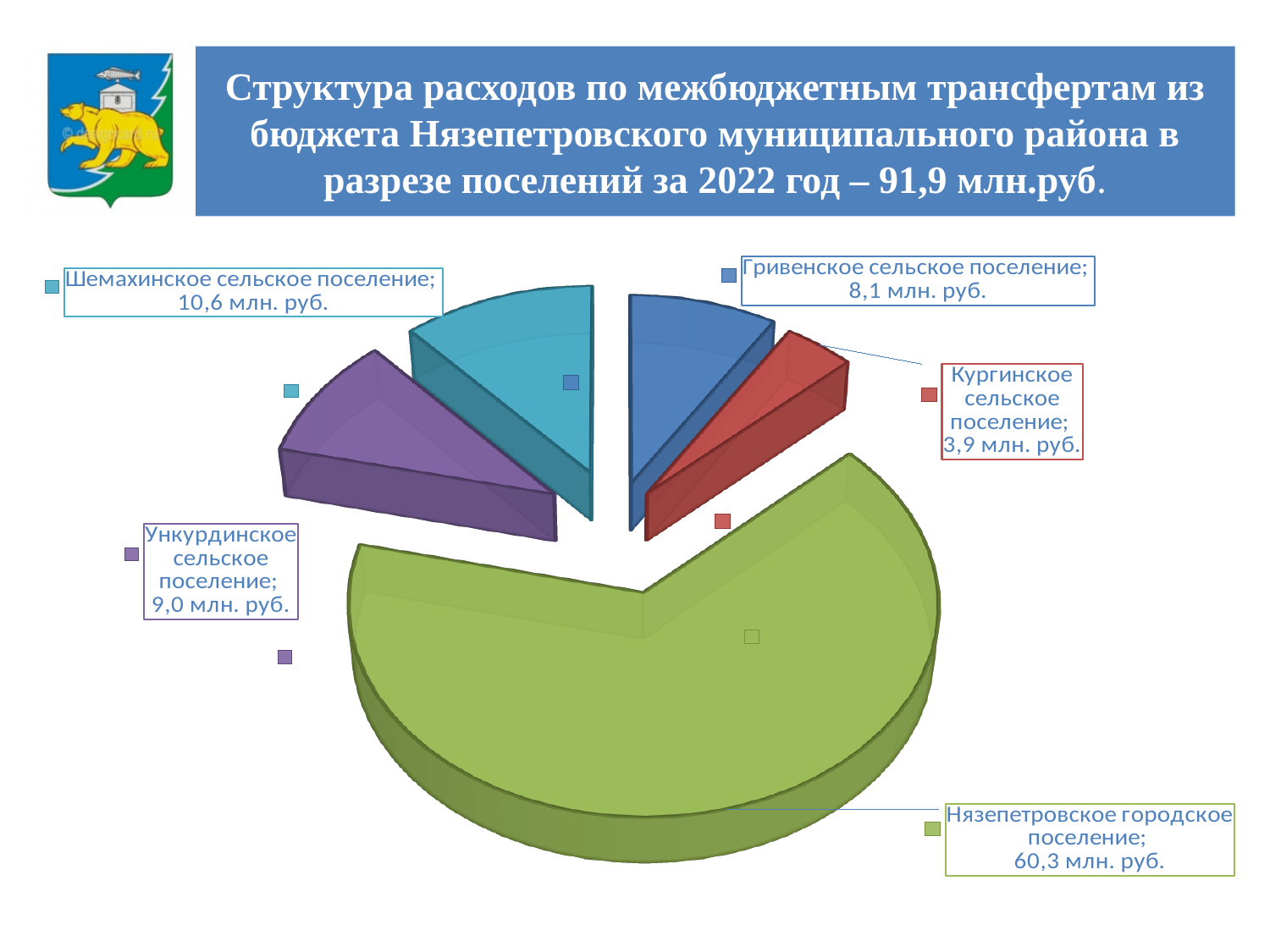
What kind of chart is shown on the slide? Pie chart Which поселение has the largest share of the pie? Нязепетровское городское поселение Which поселение has the smallest share of the pie? Кургинское сельское поселение What is the total of all the slices according to the slide title? 91,9 млн.руб. What is the value for Ункурдинское сельское поселение? 9,0 млн. руб. What is the value for Нязепетровское городское поселение? 60,3 млн. руб. What is the value for Шемахинское сельское поселение? 10,6 млн. руб. What is the value for Кургинское сельское поселение? 3,9 млн. руб. How many slices does the pie chart have? 5 What is the difference between the values for Шемахинское сельское поселение and Гривенское сельское поселение? 2,5 млн. руб. What colour is the slice for Нязепетровское городское поселение? Green Which is larger: the value for Ункурдинское сельское поселение or Гривенское сельское поселение? Ункурдинское сельское поселение